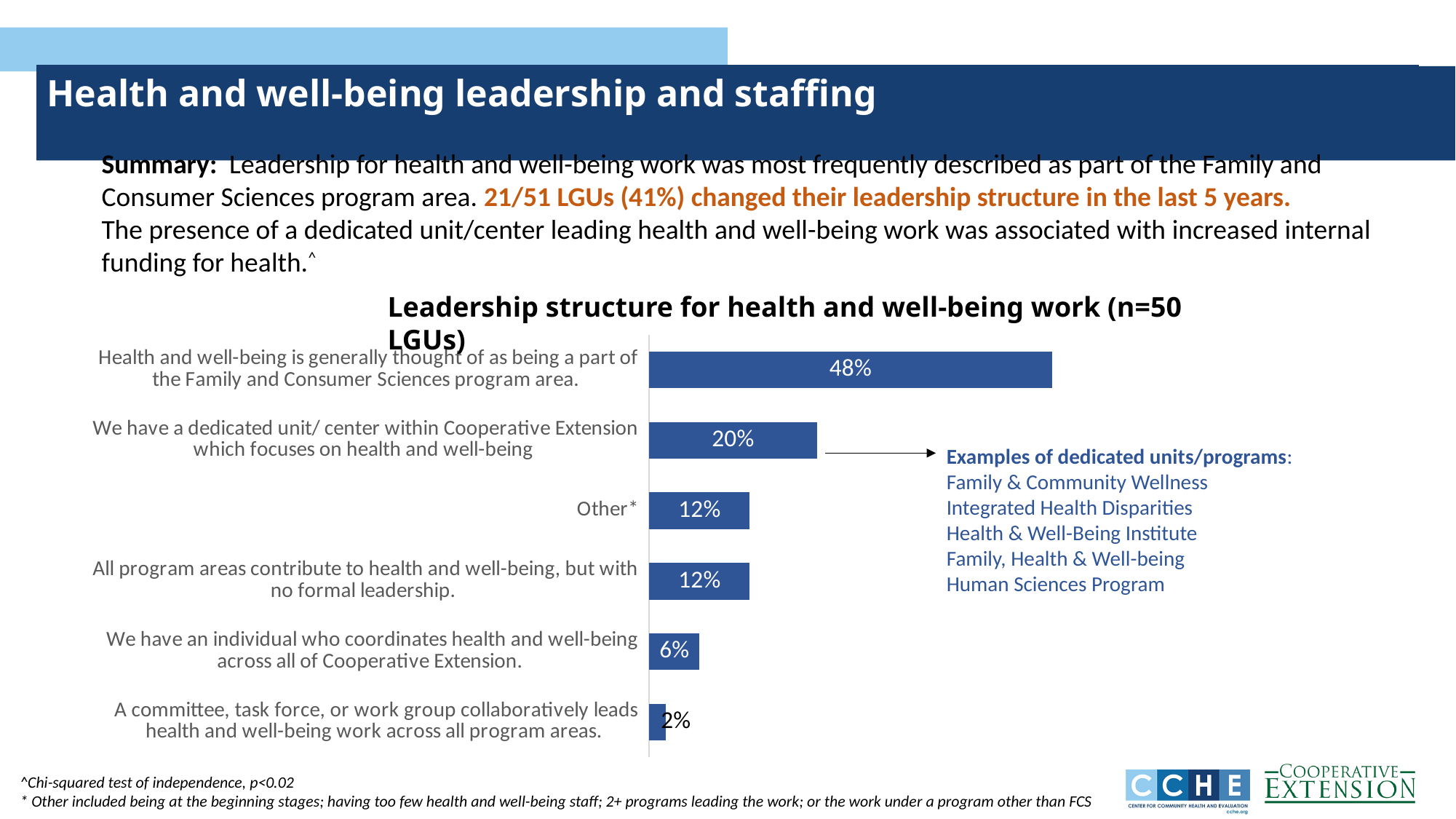
How many leadership structure categories are shown in the chart? 6 What percentage of LGUs reported that a committee, task force, or work group collaboratively leads health and well-being work? 2% What is the difference in percentage points between the Family and Consumer Sciences category and the dedicated unit/center category? 28 Which leadership structure category has the highest percentage? Health and well-being is generally thought of as being a part of the Family and Consumer Sciences program area. What percentage of LGUs have a dedicated unit/center within Cooperative Extension which focuses on health and well-being? 20% What percentage of LGUs have an individual who coordinates health and well-being across all of Cooperative Extension? 6% Which is larger: the percentage for 'Other' or the percentage for having an individual who coordinates health and well-being? Other Which leadership structure category has the lowest percentage? A committee, task force, or work group collaboratively leads health and well-being work across all program areas. What type of chart is used to show the leadership structure data? Bar chart What is the percentage for the 'Other' category? 12% What is the title of the chart? Leadership structure for health and well-being work (n=50 LGUs) What percentage of LGUs said health and well-being is generally thought of as being a part of the Family and Consumer Sciences program area? 48%